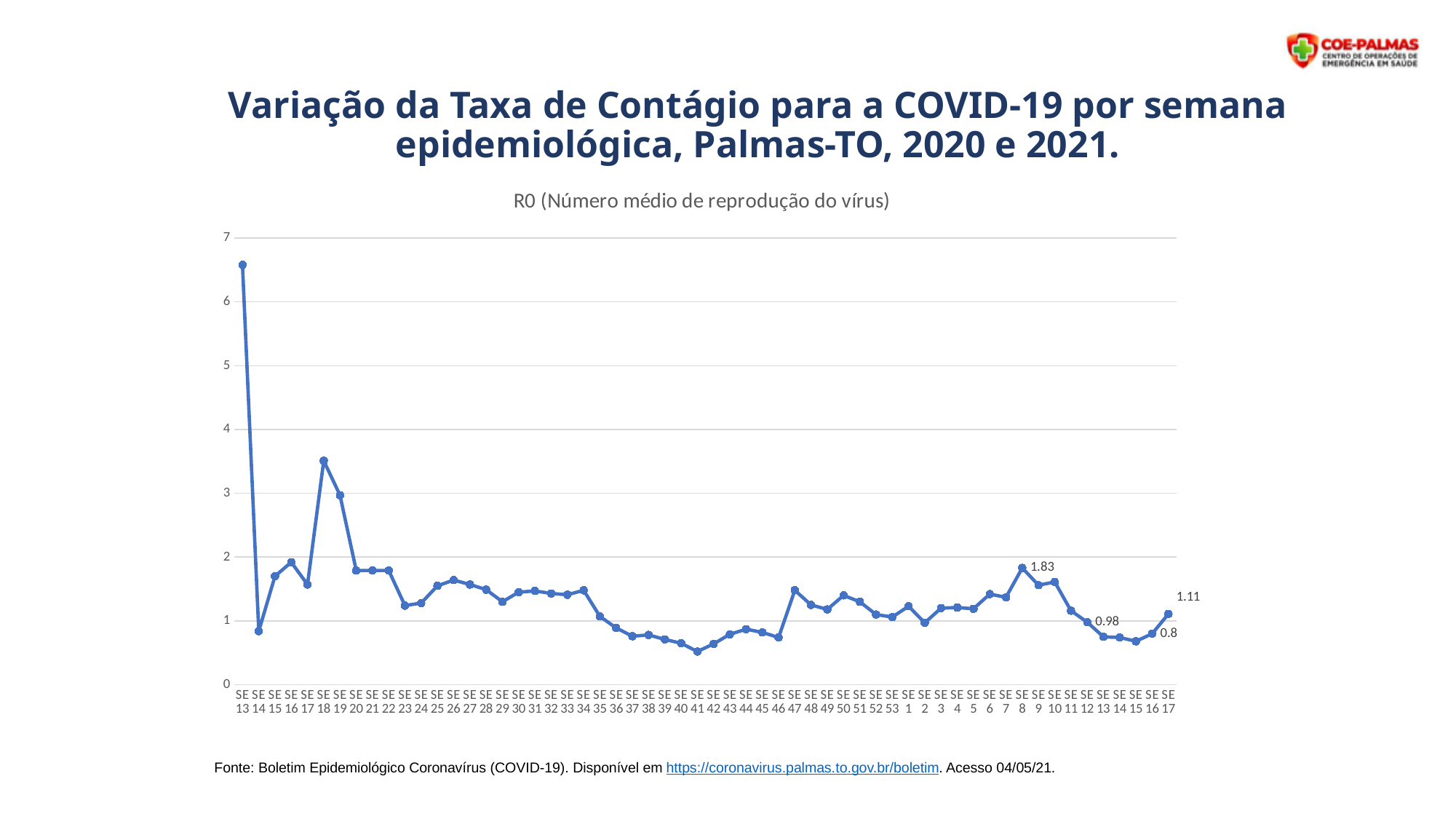
Is the R0 value for SE 41 greater or less than 1? less Which is larger, the R0 value for SE 18 or for SE 19? SE 18 Is the R0 value for the first point, SE 13 (2020), greater or less than 6? greater What is the R0 value labelled for SE 16 (2021), the second-to-last point? 0.8 Which epidemiological week has the highest R0 value on the chart? SE 13 (2020), the first point What is the R0 value labelled for SE 17 (2021), the last point on the chart? 1.11 What type of chart is shown on the slide? line chart What is the R0 value labelled for SE 12 (2021)? 0.98 What is the title shown above the chart? R0 (Número médio de reprodução do vírus) What is the R0 value labelled for SE 8 (2021)? 1.83 What is the difference between the labelled values for SE 17 (2021) and SE 16 (2021)? 0.31 What is the difference between the labelled values for SE 8 (2021) and SE 12 (2021)? 0.85